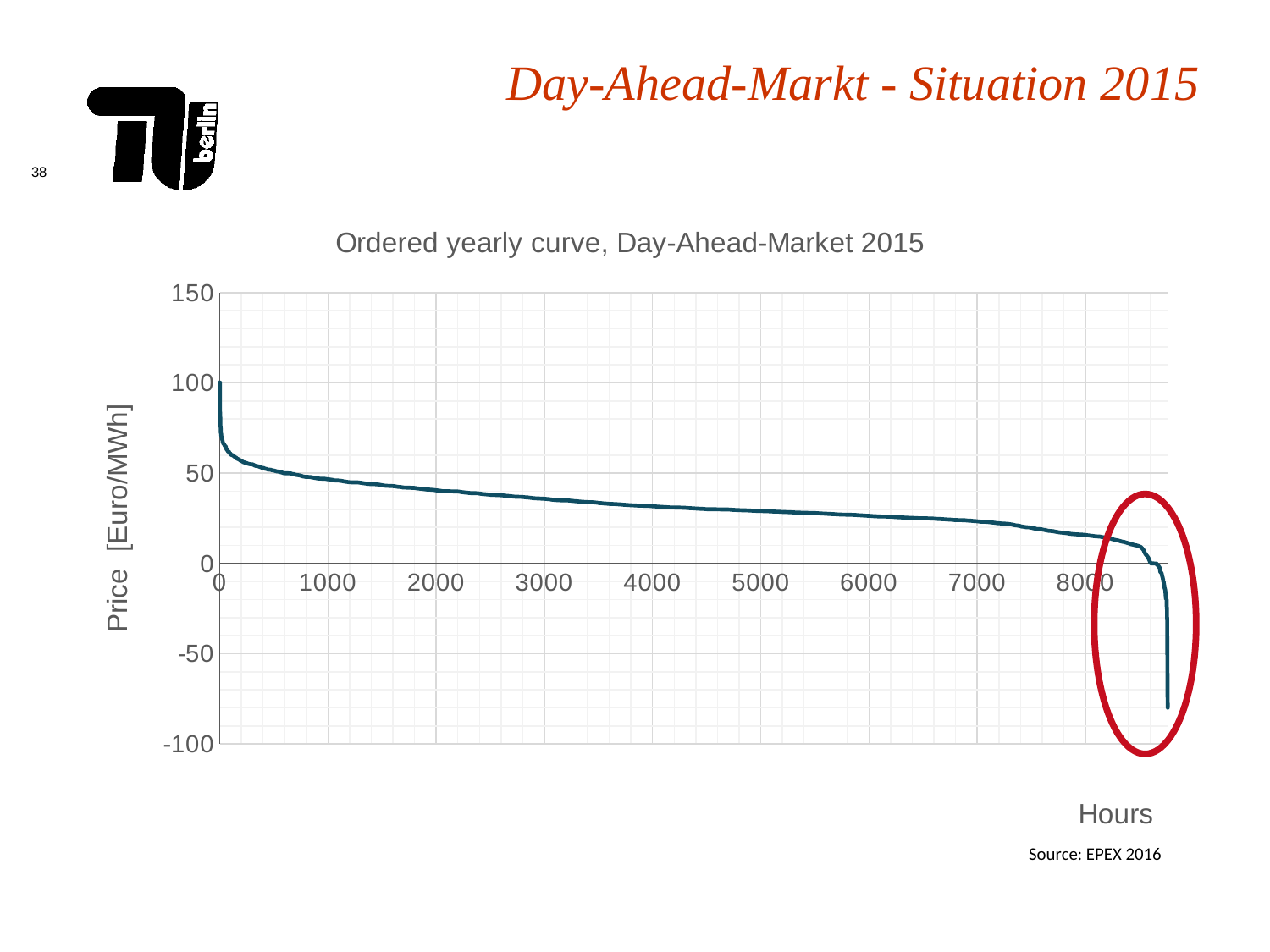
Do the prices rise or fall as the hours increase along the x axis? fall Is the price at 4000 hours greater or less than 0 Euro/MWh? greater Is the price at 0 hours greater or less than 50 Euro/MWh? greater Is the price at 2000 hours greater or less than 50 Euro/MWh? less What is the title of the chart? Ordered yearly curve, Day-Ahead-Market 2015 What is the label of the y axis? Price [Euro/MWh] What kind of chart is shown on the slide? line chart